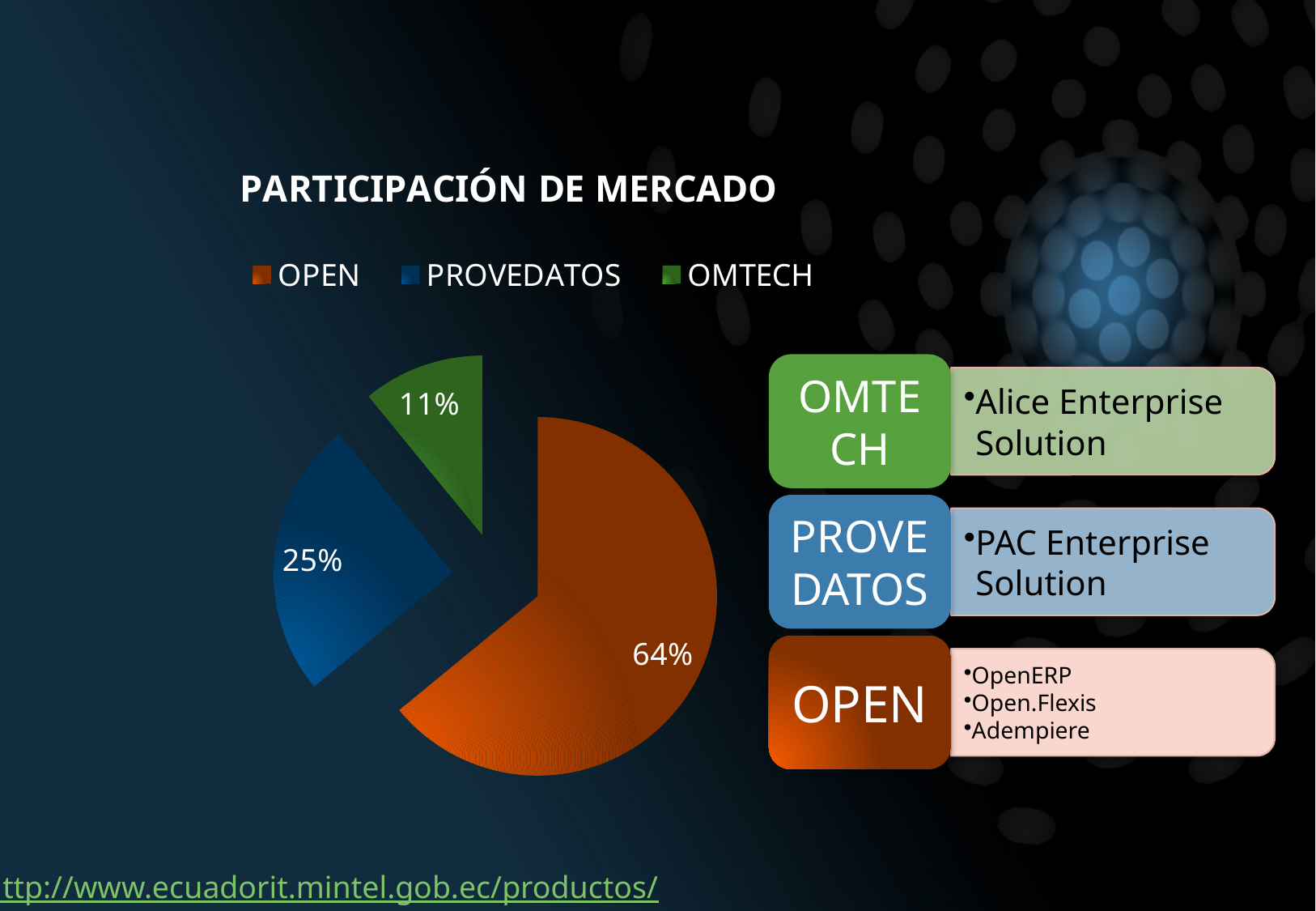
How many categories does the pie chart have? 3 What is the difference between the shares of OPEN and PROVEDATOS? 39% Which category has the smallest share of the pie? OMTECH What kind of chart is shown on the slide? pie chart What share of the pie does OPEN have? 64% What colour is the OPEN slice in the pie chart? orange What is the difference between the shares of PROVEDATOS and OMTECH? 14% What is the title of the chart? PARTICIPACIÓN DE MERCADO Which category has the largest share of the pie? OPEN What share of the pie does OMTECH have? 11% Which has a larger share, PROVEDATOS or OMTECH? PROVEDATOS What share of the pie does PROVEDATOS have? 25%